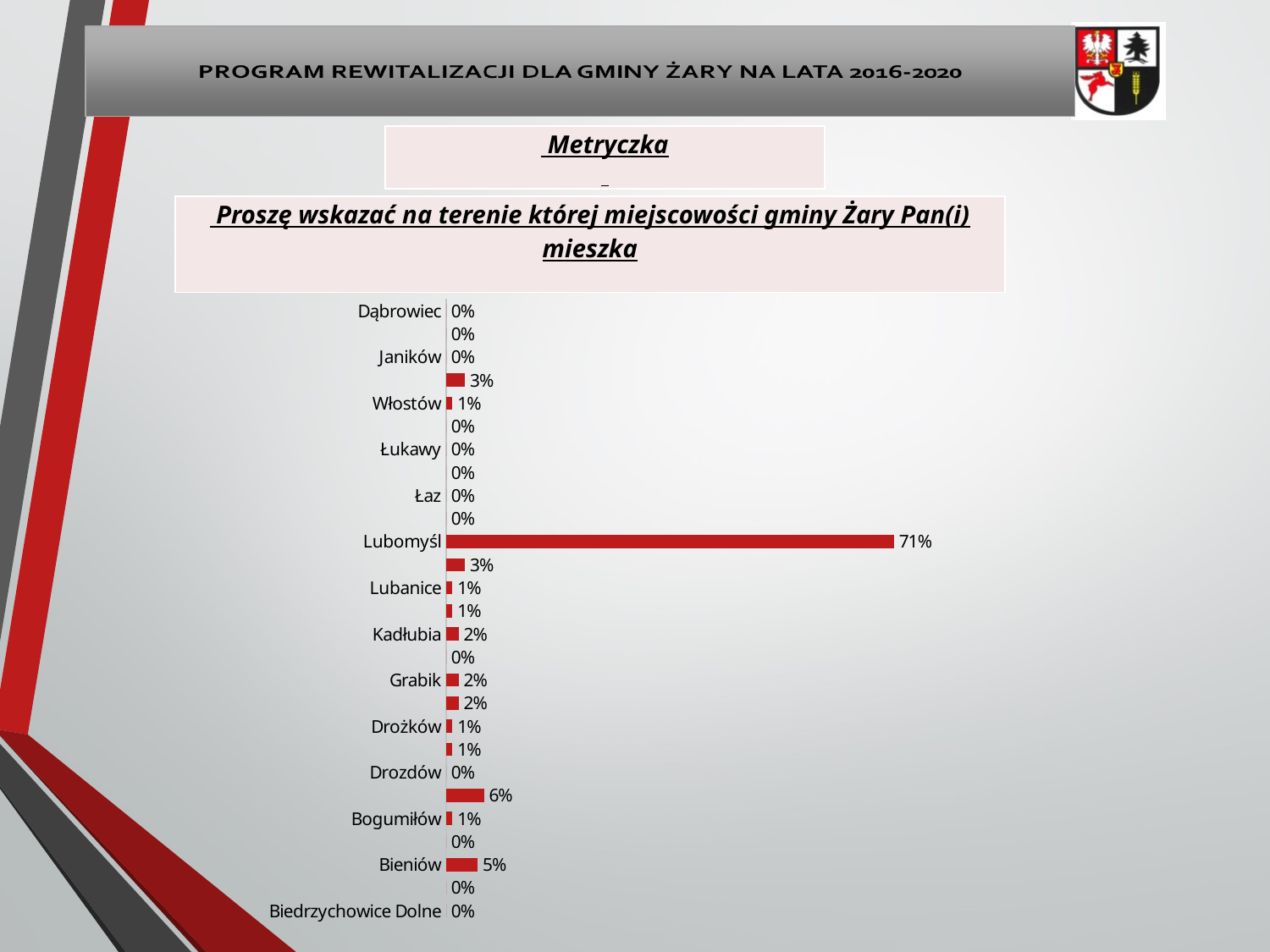
What percentage of respondents live in Lubomyśl? 71% What is the difference between the values for Lubomyśl and Bieniów? 66 percentage points What is the value shown for Bieniów? 5% Which has a larger value, Kadłubia or Drożków? Kadłubia What is the value shown for Kadłubia? 2% Which has a larger value, Bieniów or Grabik? Bieniów What kind of chart is shown on the slide? Bar chart What is the value shown for Biedrzychowice Dolne? 0% What is the value shown for Włostów? 1% Which locality has the highest value in the chart? Lubomyśl How many bars (categories) does the chart contain? 27 What question does the chart answer, according to the heading above it? Proszę wskazać na terenie której miejscowości gminy Żary Pan(i) mieszka